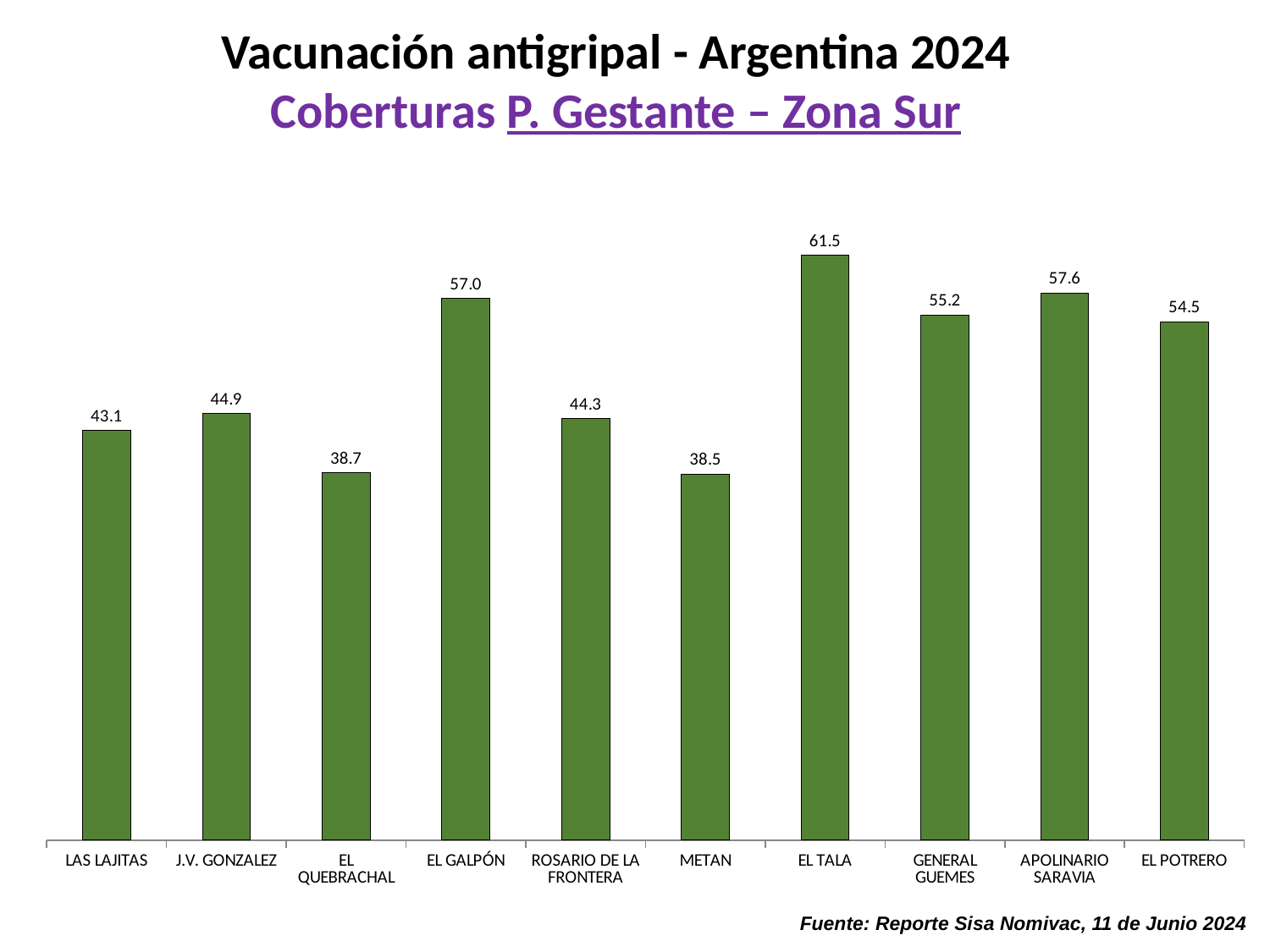
What kind of chart is shown on the slide? Bar chart What is the difference between the coverage values for EL TALA and METAN? 23.0 What is the coverage value for LAS LAJITAS? 43.1 What is the coverage value for APOLINARIO SARAVIA? 57.6 Which locality has the highest coverage value? EL TALA How many localities are shown on the chart? 10 Which has a higher coverage value, GENERAL GUEMES or EL POTRERO? GENERAL GUEMES Which locality has the lowest coverage value? METAN What is the difference between the coverage values for EL GALPÓN and J.V. GONZALEZ? 12.1 What is the source cited below the chart? Reporte Sisa Nomivac, 11 de Junio 2024 What is the coverage value for ROSARIO DE LA FRONTERA? 44.3 What is the coverage value for EL TALA? 61.5